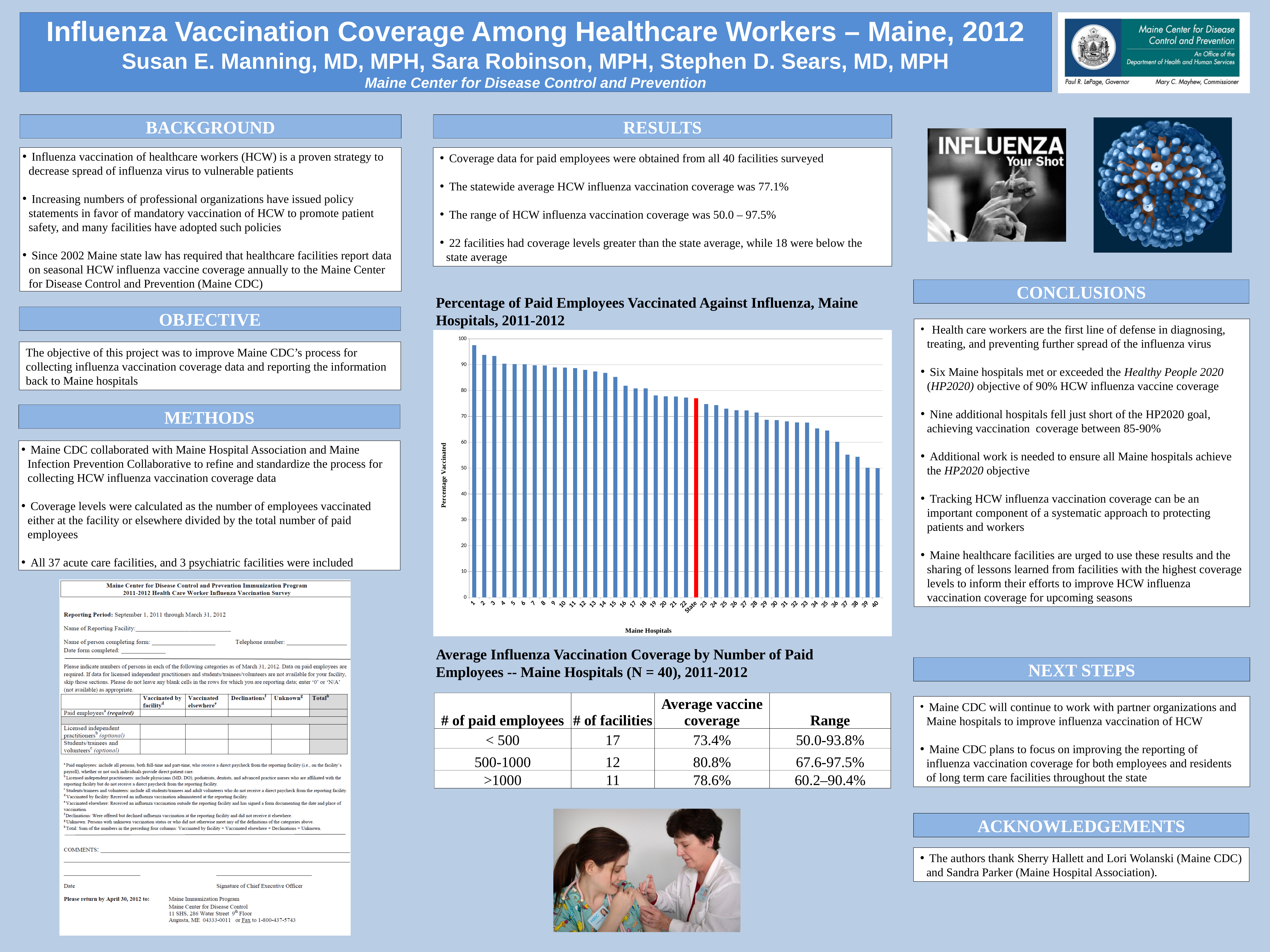
Is the value for hospital 40 greater or less than 60? less Which bar in the chart is coloured red? State Which hospital has the highest percentage vaccinated in the bar chart? 1 Do the bar values rise or fall moving from hospital 1 to hospital 40 along the x axis? fall What is the label on the y axis of the bar chart? Percentage Vaccinated What kind of chart is shown under the title 'Percentage of Paid Employees Vaccinated Against Influenza, Maine Hospitals, 2011-2012'? bar chart Is the value for hospital 37 greater or less than 60? less How many Maine hospitals are plotted along the x axis of the bar chart? 40 Is the value for hospital 1 greater or less than 90? greater Which has a higher percentage vaccinated, hospital 5 or hospital 30? hospital 5